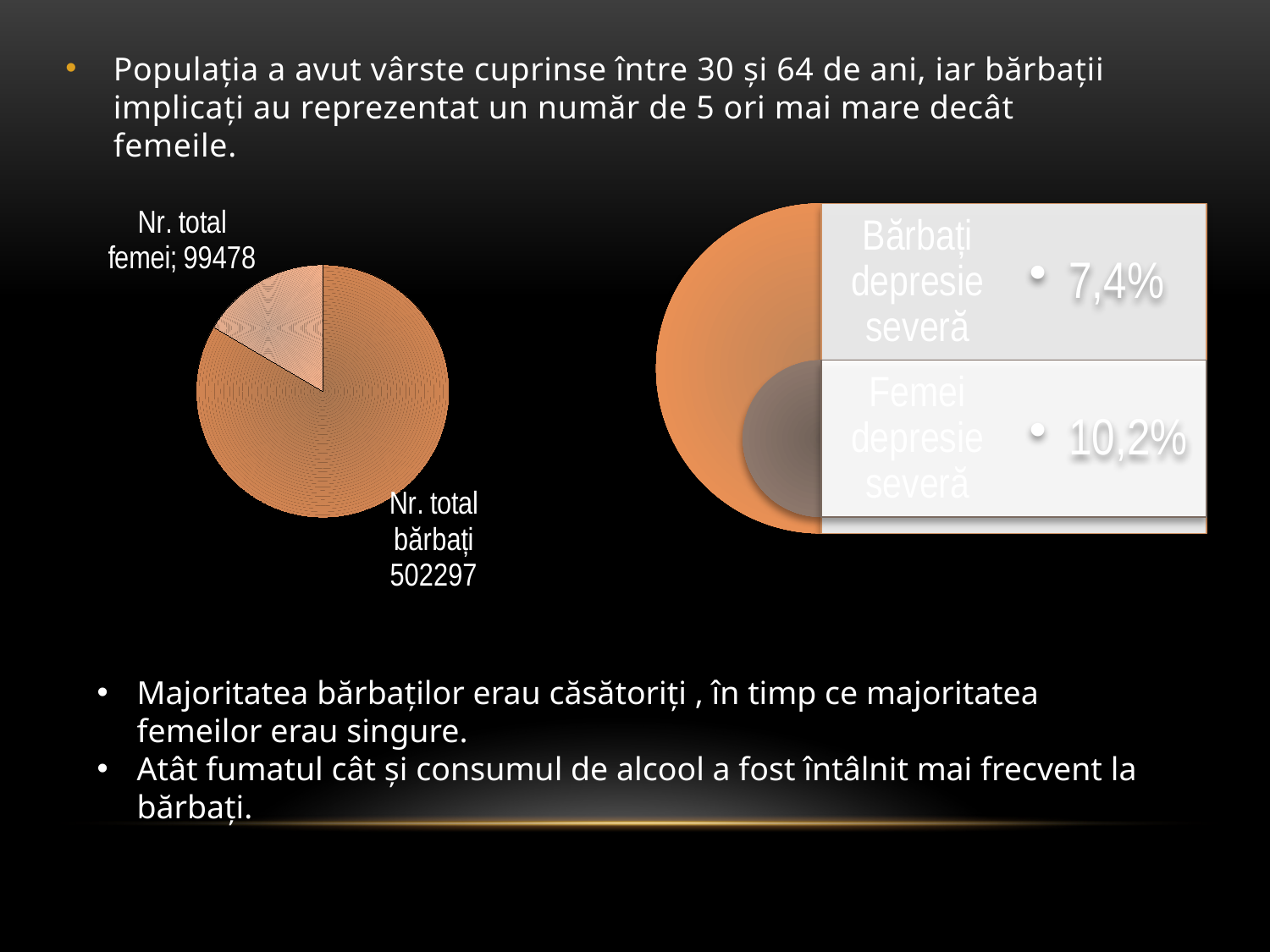
Which is larger in the pie chart, the value for "Nr. total bărbați" or the value for "Nr. total femei"? Nr. total bărbați Is the value for "Nr. total bărbați" in the pie chart greater or less than 500000? greater What is the value shown for "Nr. total bărbați" in the pie chart? 502297 What is the difference between the value for "Nr. total bărbați" and the value for "Nr. total femei" in the pie chart? 402819 What colour is the larger slice of the pie chart? orange Which category has the largest slice in the pie chart? Nr. total bărbați Which category has the smallest slice in the pie chart? Nr. total femei What is the value shown for "Nr. total femei" in the pie chart? 99478 Is the value for "Nr. total femei" in the pie chart greater or less than 100000? less How many slices does the pie chart have? 2 What type of chart is shown on the slide? pie chart